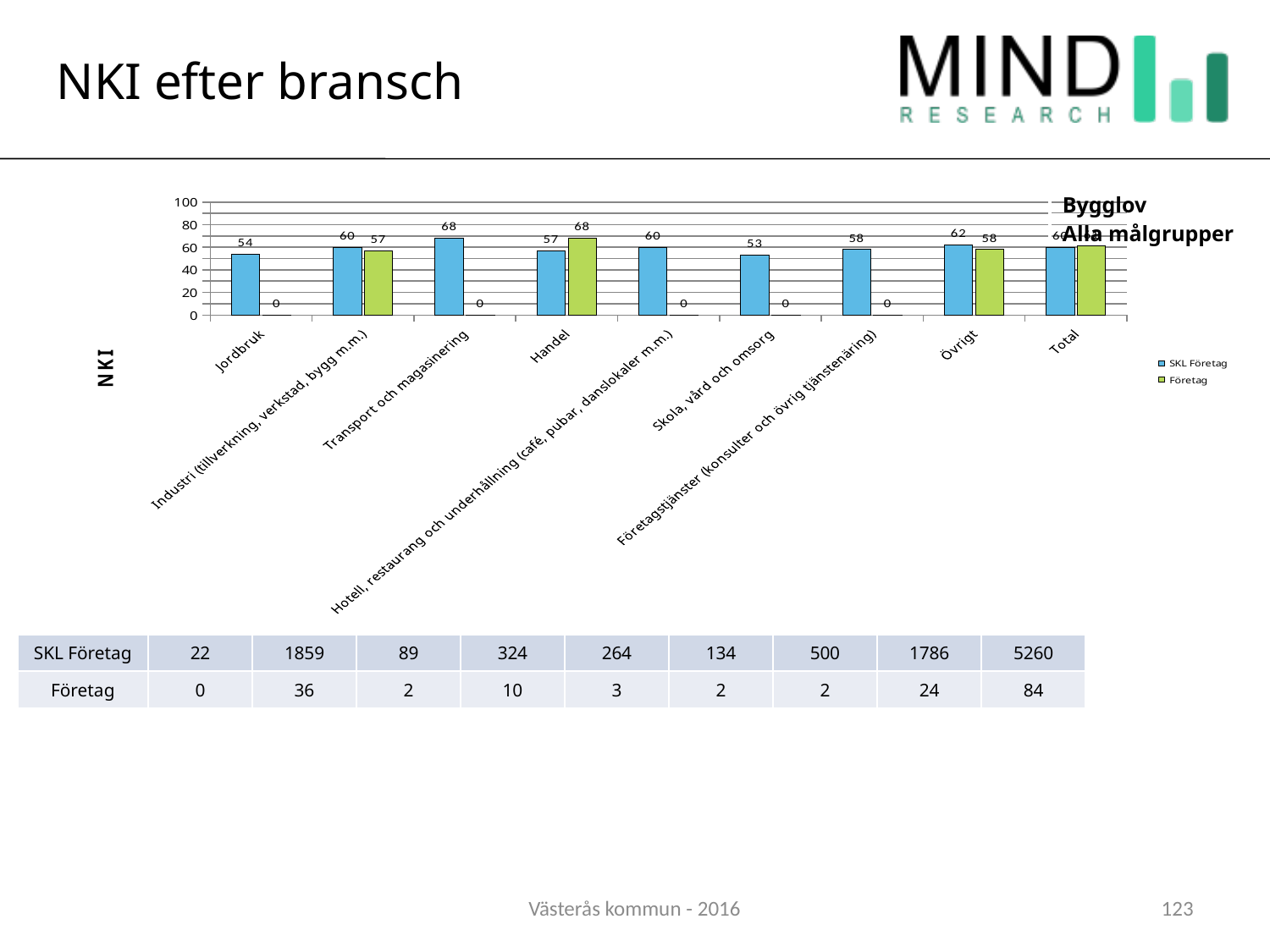
What is the Företag value for Handel? 68 What is the Företag value for Jordbruk? 0 How many series does the legend list? 2 What kind of chart is shown on the slide? Bar chart Which is larger for Övrigt: the SKL Företag value or the Företag value? SKL Företag What is the SKL Företag value for Jordbruk? 54 What is the Företag value for Industri (tillverkning, verkstad, bygg m.m.)? 57 What is the SKL Företag value for Övrigt? 62 What is the difference between the SKL Företag and Företag values for Handel? 11 What is the SKL Företag value for Skola, vård och omsorg? 53 Is the SKL Företag value for Transport och magasinering greater or less than 60? greater Which category has the lowest SKL Företag value? Skola, vård och omsorg